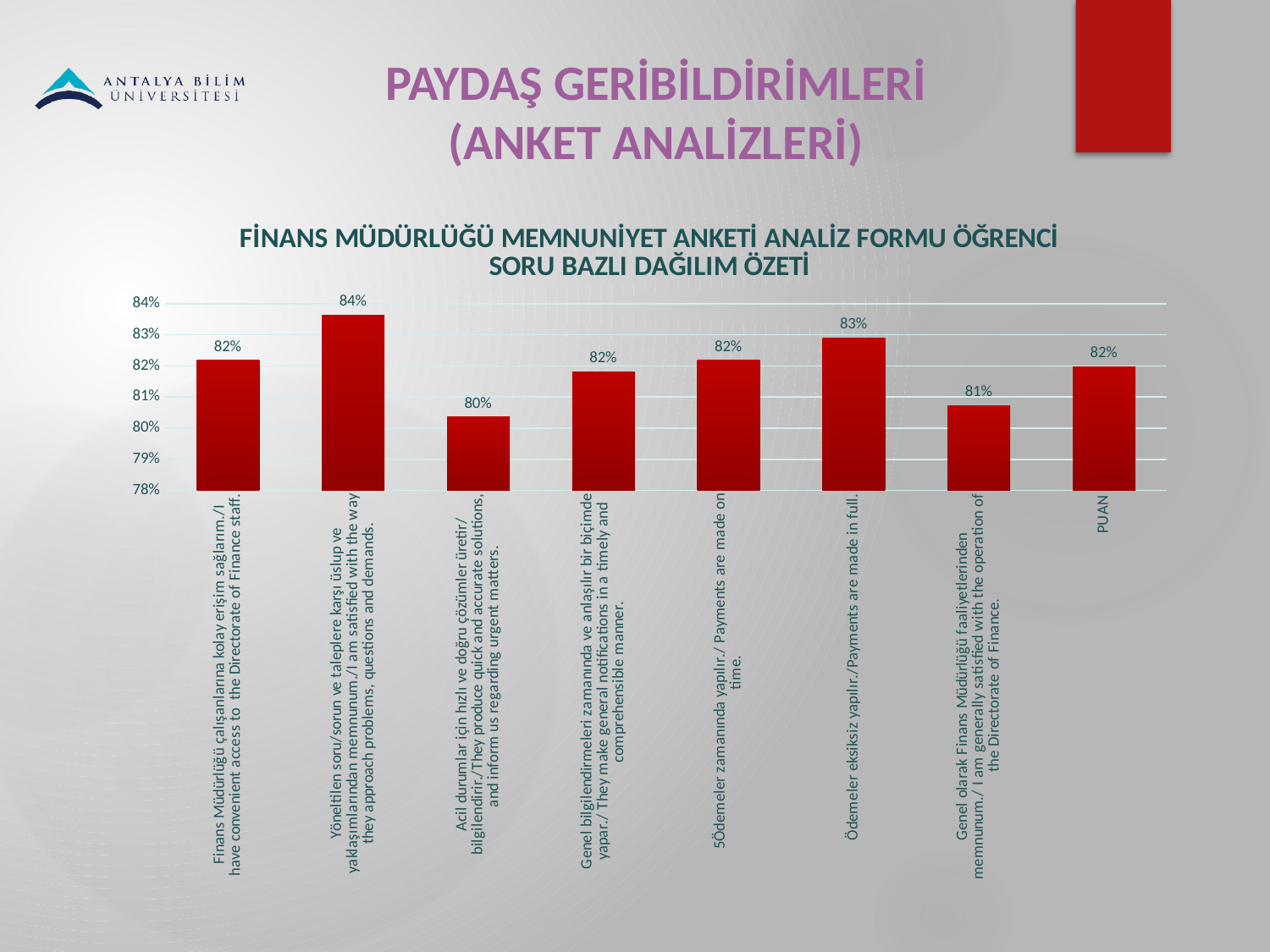
How many bars (categories) does the chart show? 8 Which is larger: the value for "Payments are made in full" or the value for "Payments are made on time"? Payments are made in full (83%) What is the value of the PUAN bar? 82% Is the value for "Acil durumlar için hızlı ve doğru çözümler üretir" greater or less than 82%? less What is the difference between the highest value (84%) and the lowest value (80%) in the chart? 4 percentage points What is the lowest value shown on the vertical axis of the chart? 78% What is the value for "Genel olarak Finans Müdürlüğü faaliyetlerinden memnunum./ I am generally satisfied with the operation of the Directorate of Finance."? 81% What is the title of the chart? FİNANS MÜDÜRLÜĞÜ MEMNUNİYET ANKETİ ANALİZ FORMU ÖĞRENCİ SORU BAZLI DAĞILIM ÖZETİ Which category has the highest value in the chart? Yöneltilen soru/sorun ve taleplere karşı üslup ve yaklaşımlarından memnunum./I am satisfied with the way they approach problems, questions and demands. What is the value for "Ödemeler eksiksiz yapılır./Payments are made in full."? 83% Which category has the lowest value in the chart? Acil durumlar için hızlı ve doğru çözümler üretir/bilgilendirir./They produce quick and accurate solutions, and inform us regarding urgent matters. What type of chart is shown on the slide? Bar chart